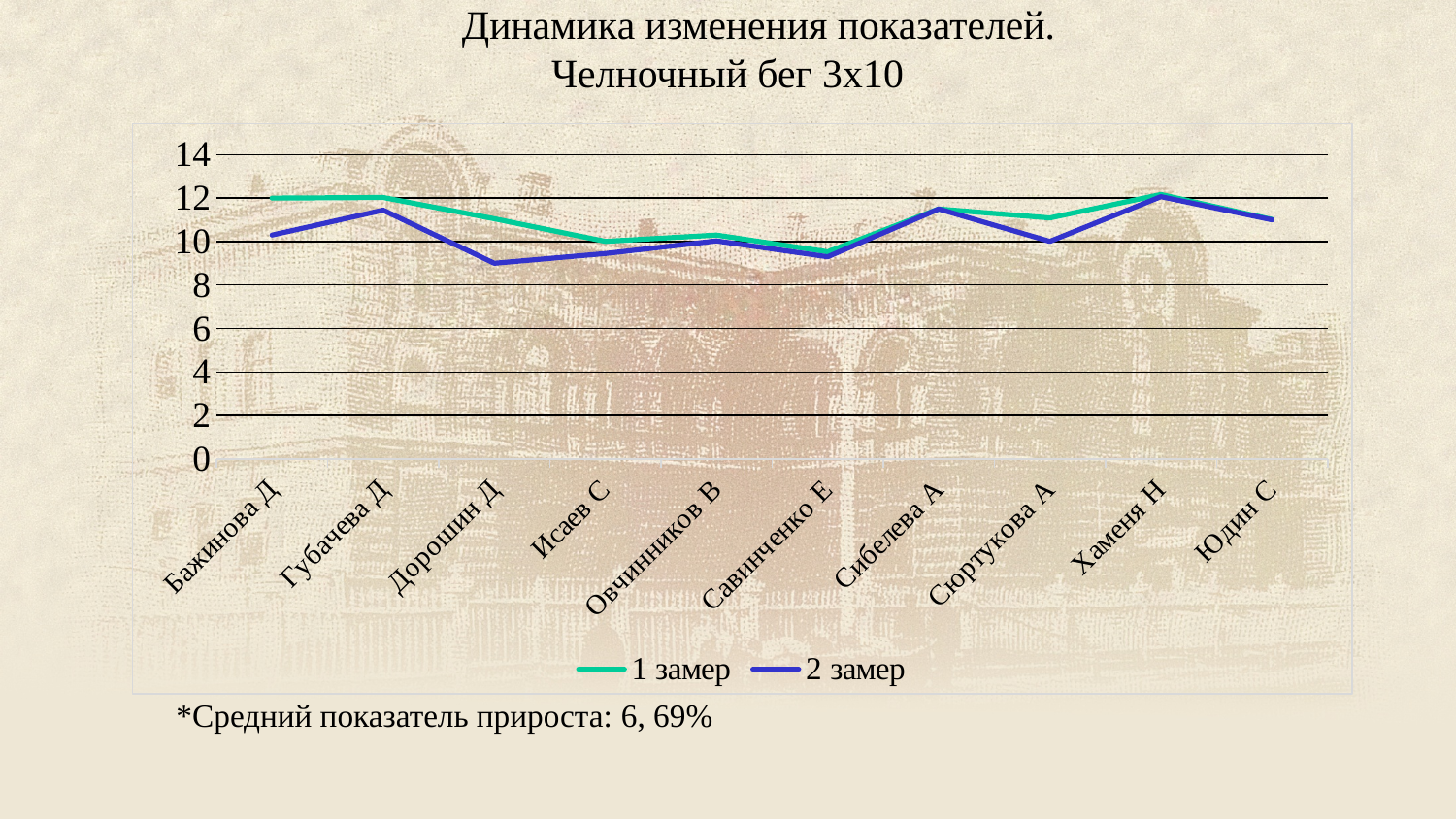
Is the value for Дорошин Д in the 2 замер series greater or less than 10? less What are the two series named in the legend? 1 замер, 2 замер What kind of chart is shown on the slide? line chart For Бажинова Д, which series has the larger value, 1 замер or 2 замер? 1 замер Is the value for Хаменя Н in the 2 замер series greater or less than 10? greater What is the title of the chart? Динамика изменения показателей. Челночный бег 3х10 Is the value for Губачева Д in the 1 замер series greater or less than 10? greater How many categories (people) are shown on the x axis? 10 How many series does the legend list? 2 Which category has the highest value in the 2 замер series? Хаменя Н Does the 2 замер series rise or fall from Губачева Д to Дорошин Д? fall